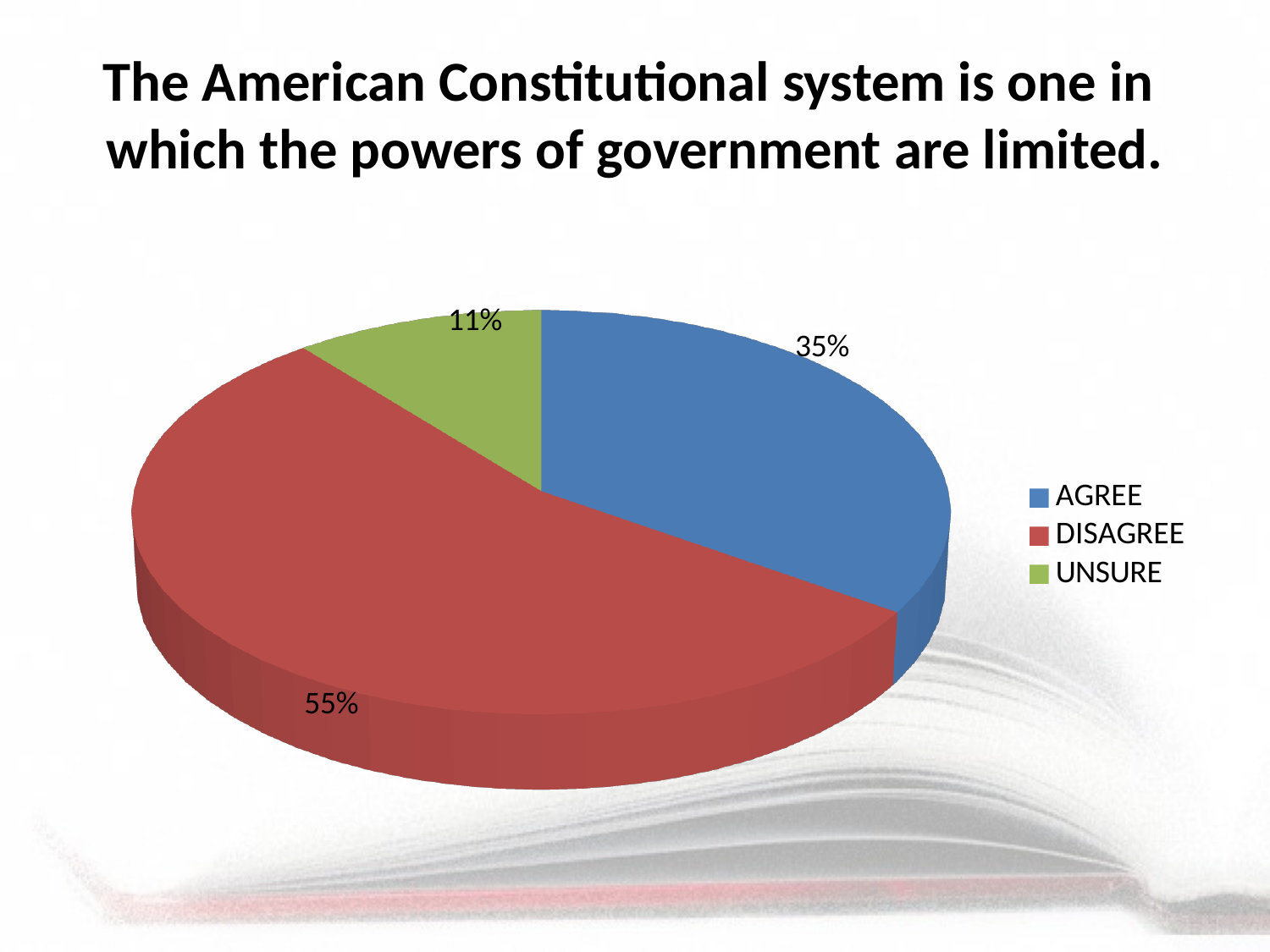
What kind of chart is shown on the slide? Pie chart Which response has the smallest share of the pie? UNSURE What percentage of respondents chose DISAGREE? 55% What is the difference in percentage points between AGREE and UNSURE? 24 What colour is the DISAGREE slice? Red What is the difference in percentage points between DISAGREE and AGREE? 20 Which response has the largest share of the pie? DISAGREE How many slices does the pie chart have? 3 Which is larger, the share for AGREE or the share for UNSURE? AGREE What percentage of respondents chose AGREE? 35% What percentage of respondents chose UNSURE? 11% How many entries does the legend list? 3